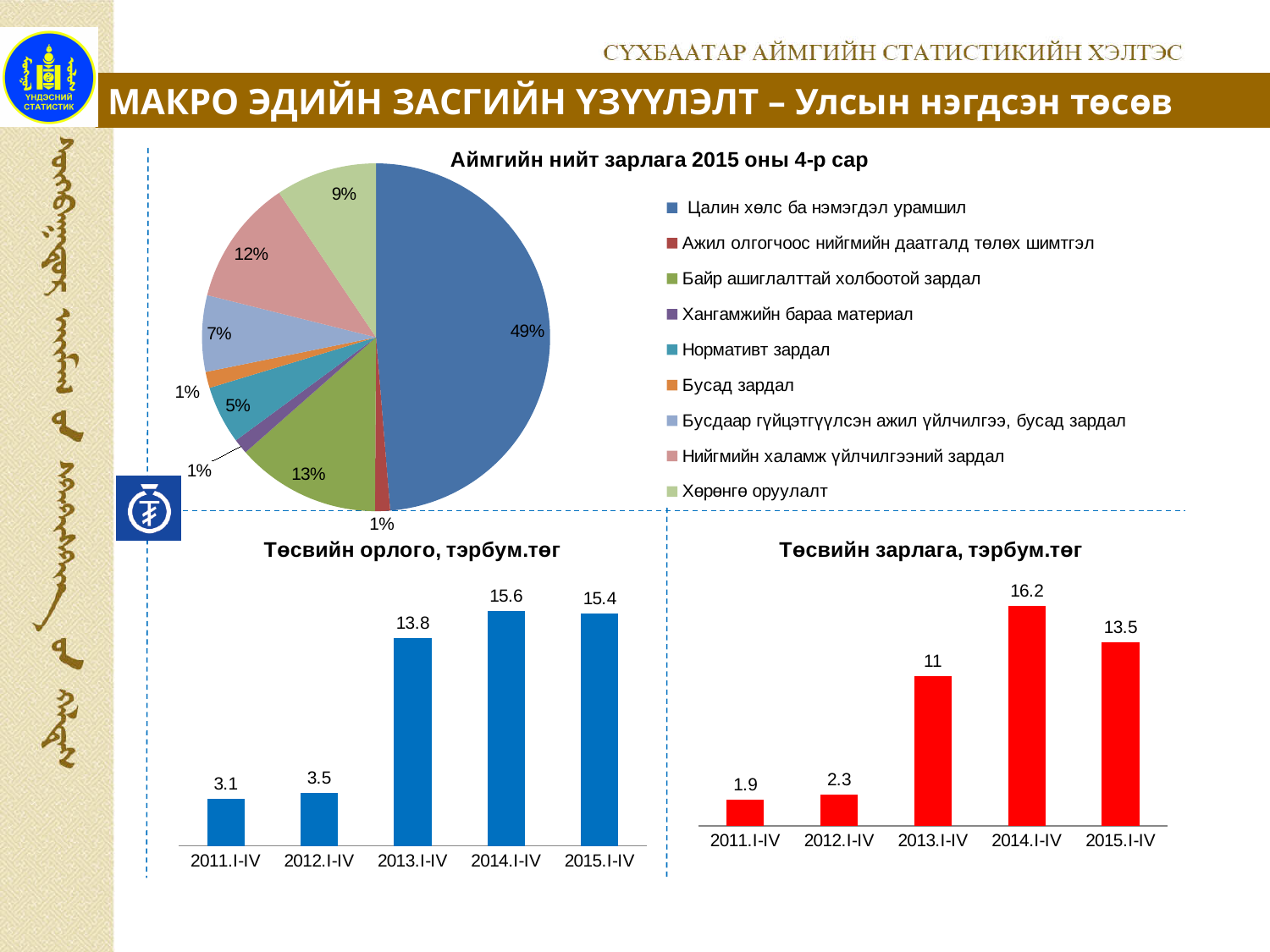
How many periods are shown on the x axis of the 'Төсвийн орлого, тэрбум.төг' chart? 5 In the 'Төсвийн орлого, тэрбум.төг' chart, what is the difference between the values for 2012.I-IV and 2011.I-IV? 0.4 In the 'Төсвийн зарлага, тэрбум.төг' chart, what is the difference between the values for 2014.I-IV and 2015.I-IV? 2.7 In the 'Төсвийн зарлага, тэрбум.төг' chart, what is the value for 2014.I-IV? 16.2 What kind of chart is 'Аймгийн нийт зарлага 2015 оны 4-р сар'? Pie chart In the pie chart 'Аймгийн нийт зарлага 2015 оны 4-р сар', what share does 'Нийгмийн халамж үйлчилгээний зардал' have? 12% In the 'Төсвийн орлого, тэрбум.төг' chart, which period has the highest value? 2014.I-IV In the pie chart 'Аймгийн нийт зарлага 2015 оны 4-р сар', what share does 'Цалин хөлс ба нэмэгдэл урамшил' have? 49% How many entries does the legend of the pie chart 'Аймгийн нийт зарлага 2015 оны 4-р сар' list? 9 In the 'Төсвийн зарлага, тэрбум.төг' chart, which is larger: the value for 2013.I-IV or 2015.I-IV? 2015.I-IV In the 'Төсвийн зарлага, тэрбум.төг' chart, which period has the lowest value? 2011.I-IV In the 'Төсвийн орлого, тэрбум.төг' chart, what is the value for 2013.I-IV? 13.8